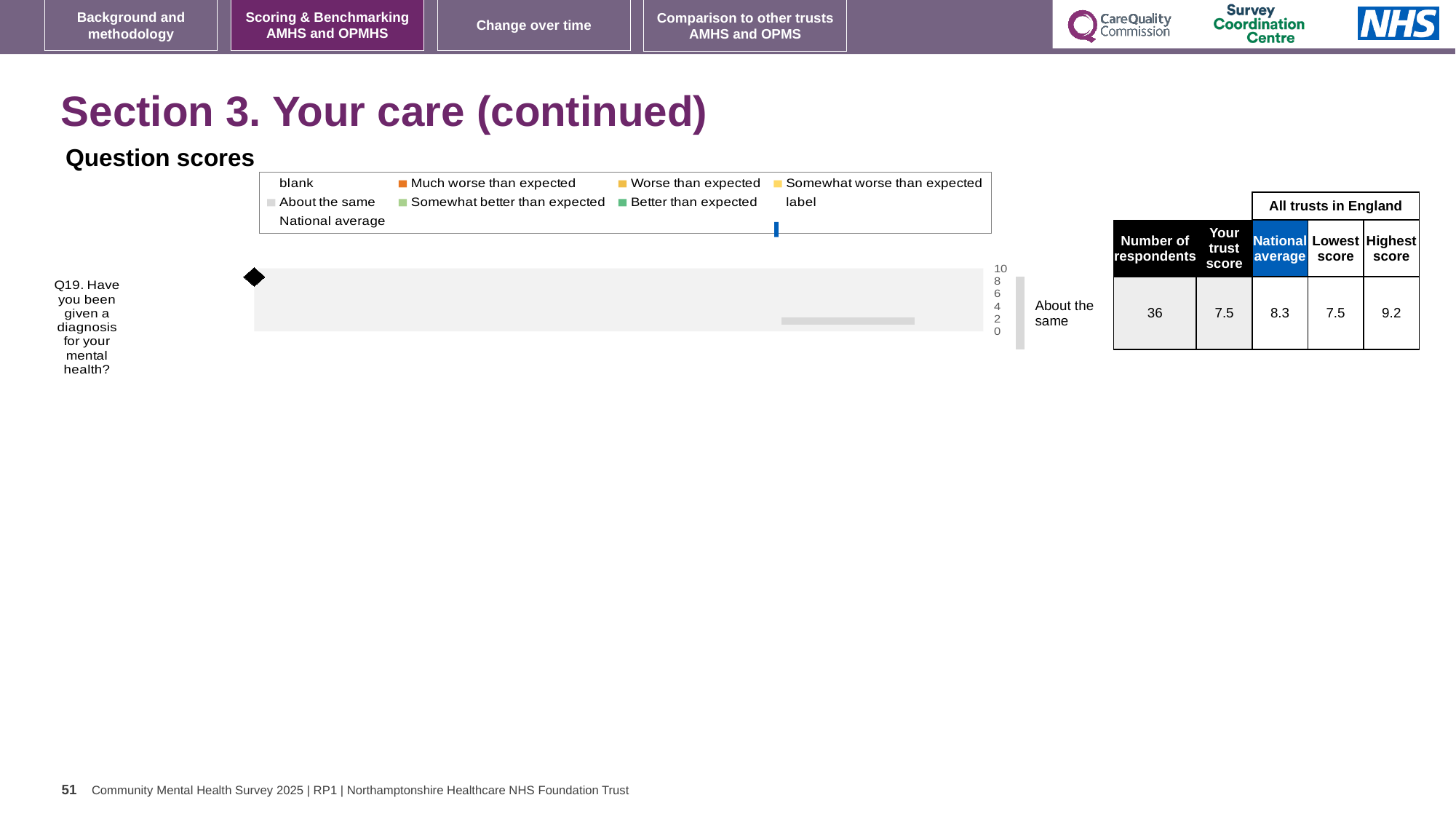
Which question is shown in the question scores chart? Q19. Have you been given a diagnosis for your mental health? What is the difference between the highest score and the lowest score for Q19? 1.7 What is the highest score across all trusts in England for Q19? 9.2 How many questions are plotted in the question scores chart? 1 What is the national average for Q19 shown alongside the question scores chart? 8.3 Which is larger for Q19, the trust score or the national average? National average What kind of chart is used to show the question scores on this slide? bar chart How many respondents answered Q19? 36 What is the trust score for Q19 shown alongside the question scores chart? 7.5 What benchmark category is shown for Q19 in the question scores chart? About the same What is the lowest score across all trusts in England for Q19? 7.5 What is the difference between the national average and the trust score for Q19? 0.8